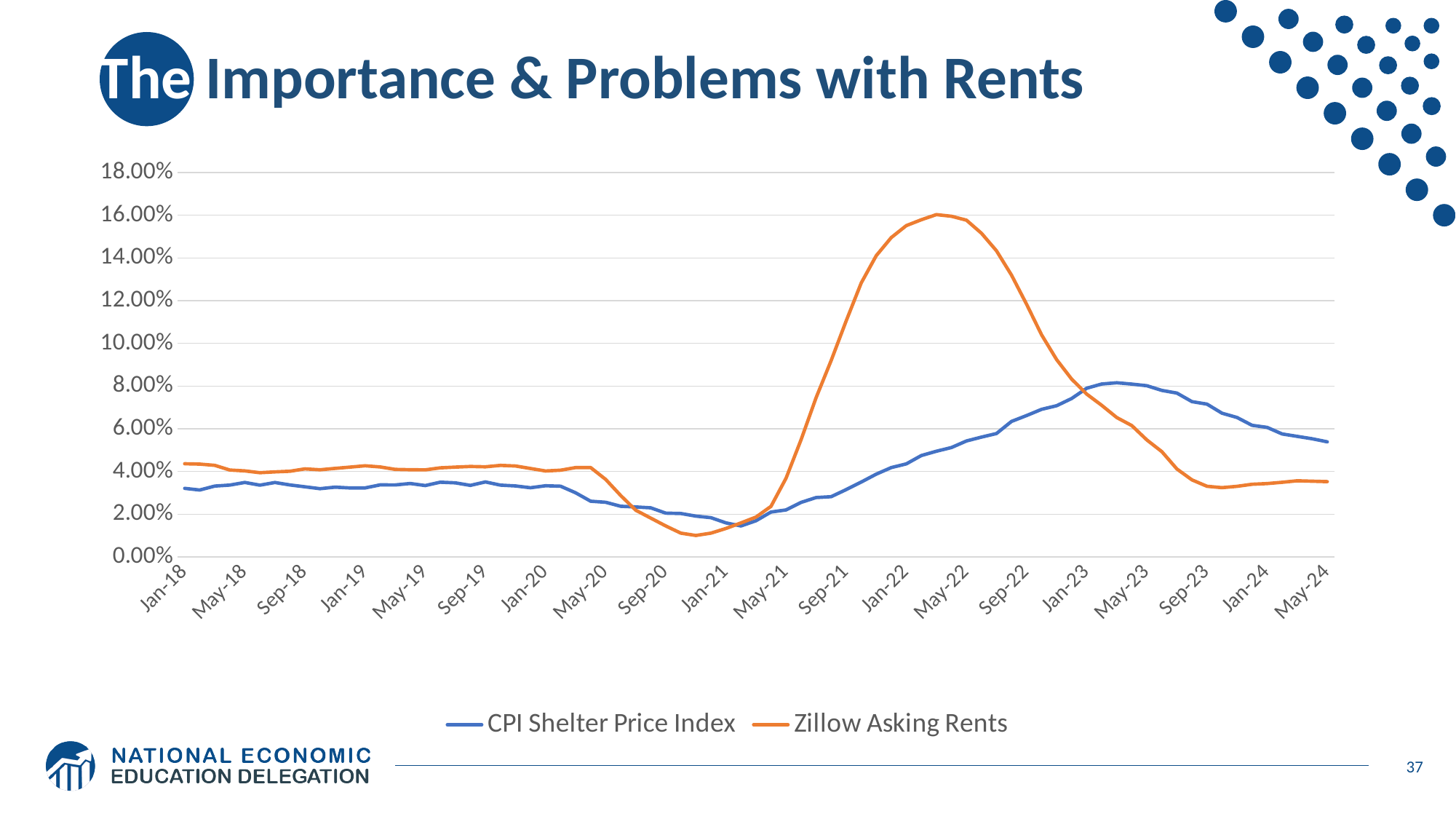
How many series does the legend list? 2 Is the value for Zillow Asking Rents at Jan-21 greater or less than 2.00%? less Does the CPI Shelter Price Index rise or fall between May-23 and May-24? fall At Jan-22, which series has the higher value, CPI Shelter Price Index or Zillow Asking Rents? Zillow Asking Rents Is the value for Zillow Asking Rents at May-22 greater or less than 14.00%? greater Is the value for CPI Shelter Price Index at May-23 greater or less than 6.00%? greater At May-23, which series has the higher value, CPI Shelter Price Index or Zillow Asking Rents? CPI Shelter Price Index Which series reaches the higher peak value over the period shown? Zillow Asking Rents What are the two series named in the legend? CPI Shelter Price Index and Zillow Asking Rents Does Zillow Asking Rents rise or fall between Jan-21 and May-22? rise What kind of chart is shown on the slide? line chart